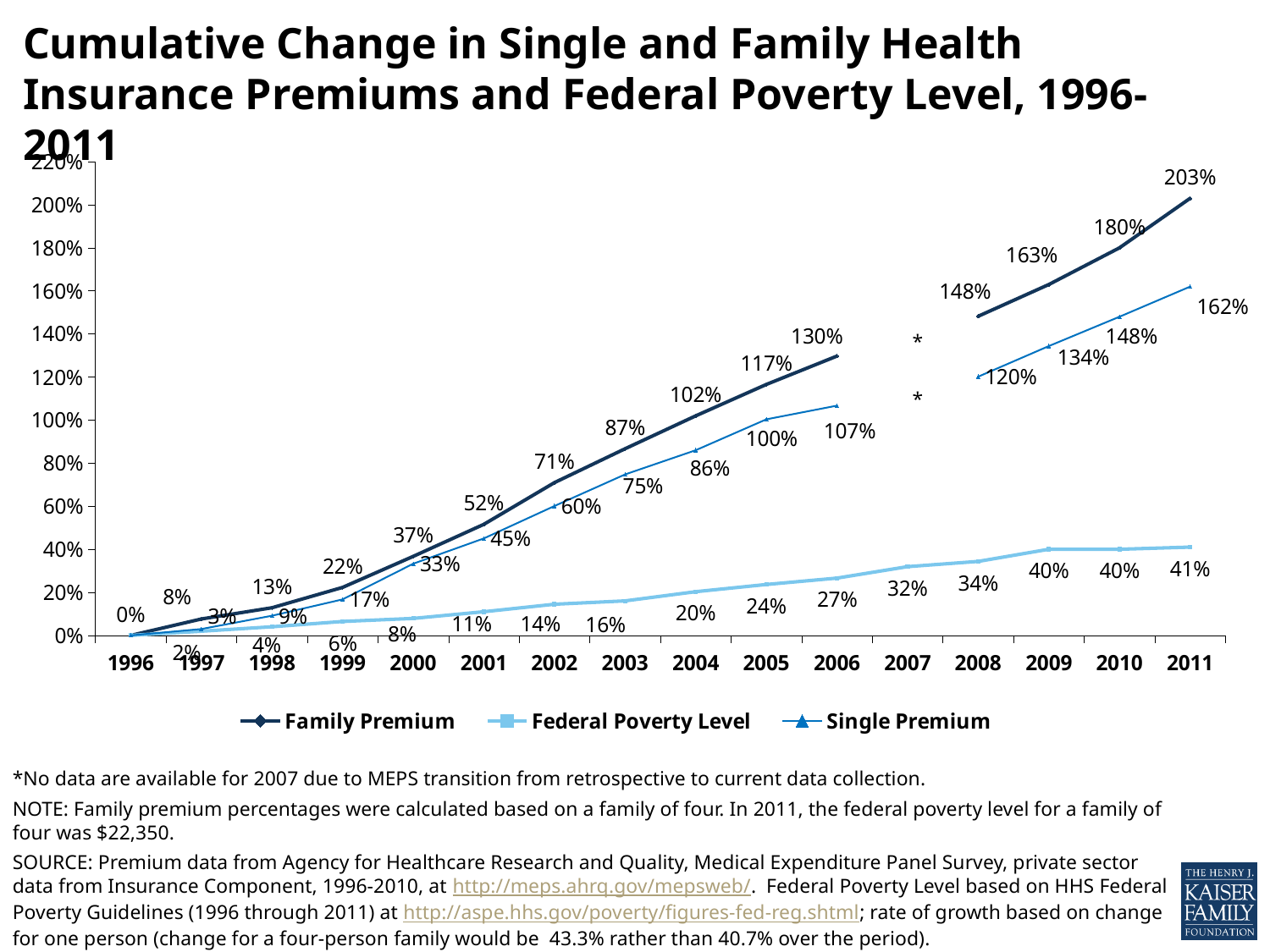
What is the Federal Poverty Level value for 2009? 40% For which year does the chart show no data, marked with an asterisk? 2007 What is the difference between the Family Premium and Single Premium values in 2011? 41% What kind of chart is shown on the slide? Line chart Does the Family Premium series rise or fall from 1996 to 2011? Rise How many series does the legend list? 3 What is the Single Premium value for 2006? 107% Which series has the lowest value in 2008? Federal Poverty Level Which series has the highest value in 2011? Family Premium What is the Family Premium value for 2002? 71% Which is larger in 2005: the Single Premium value or the Federal Poverty Level value? Single Premium What is the Family Premium value for 2011? 203%